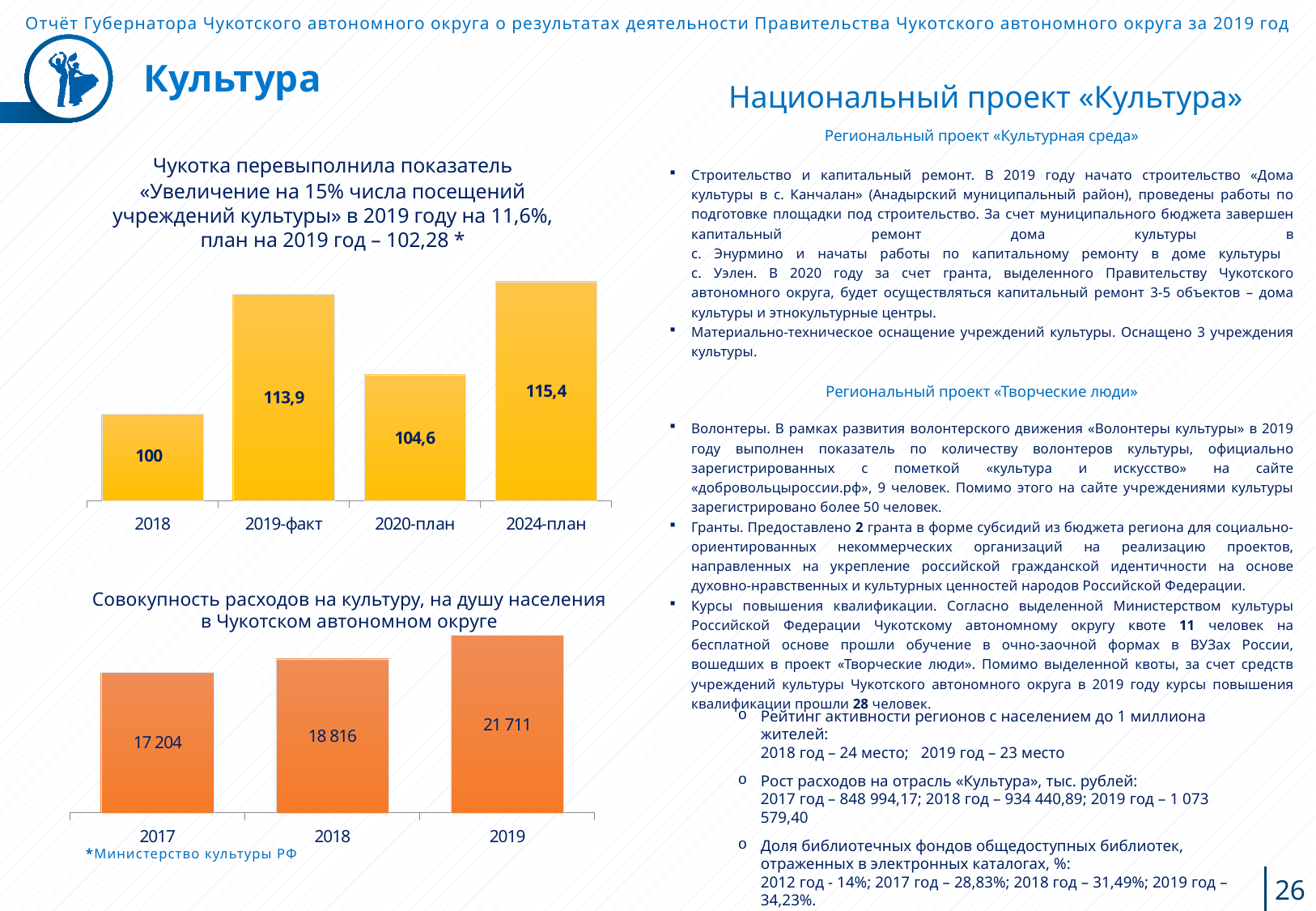
In the top chart, what is the value for 2019-факт? 113,9 In the bottom chart, what is the value for 2019? 21 711 What type of chart is the bottom chart? bar chart In the bottom chart, do the values rise or fall from 2017 to 2019? rise In the bottom chart, what is the value for 2017? 17 204 In the top chart, which category has the lowest value? 2018 In the top chart, which is larger: the value for 2019-факт or the value for 2020-план? 2019-факт In the bottom chart, what is the difference between the values for 2019 and 2018? 2 895 How many bars are in the top chart? 4 In the top chart, which category has the highest value? 2024-план In the top chart, what is the value for 2020-план? 104,6 In the top chart, what is the difference between the values for 2024-план and 2018? 15,4